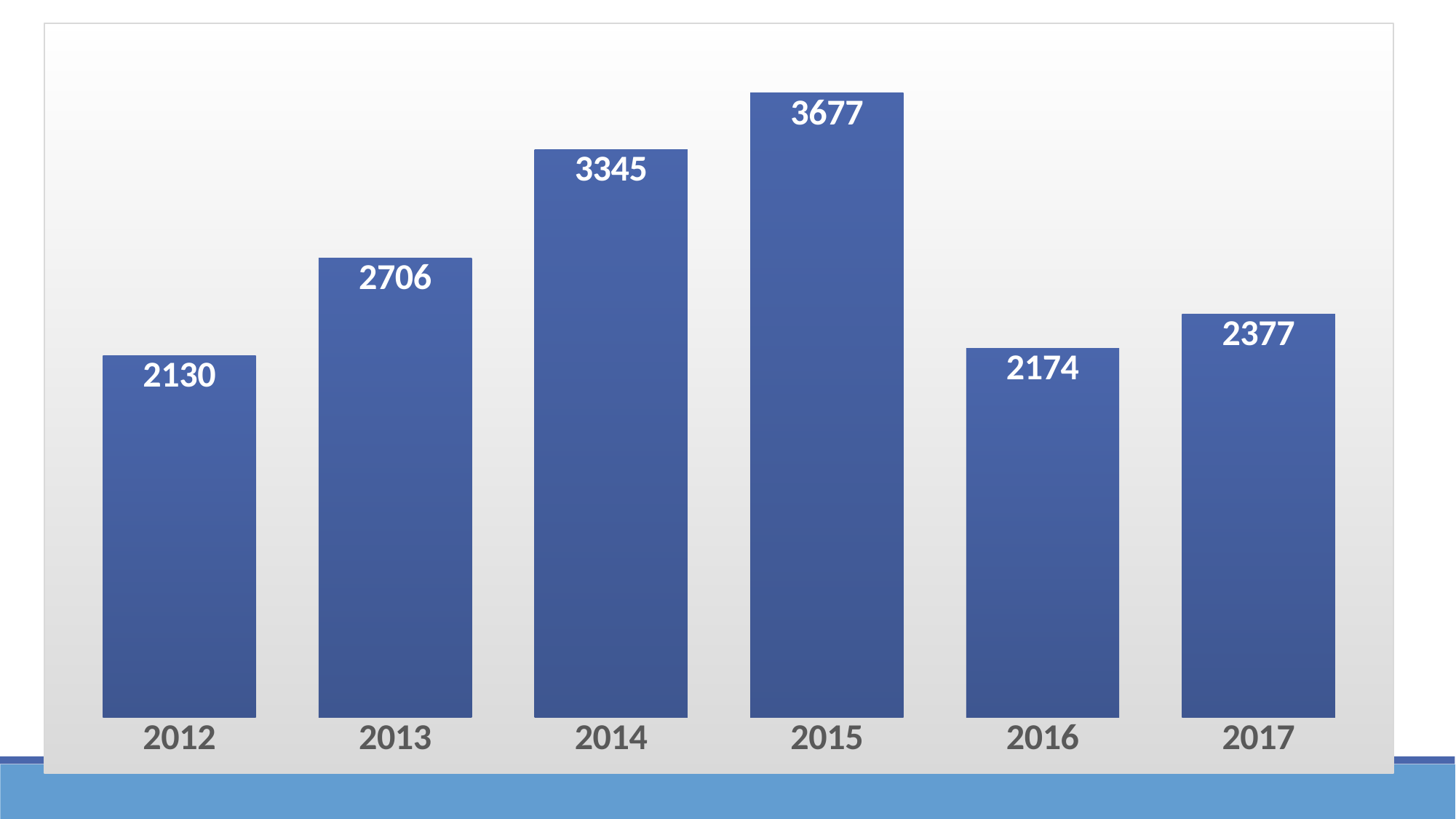
Which is larger, the value for 2013 or the value for 2014? 2014 What is the value for 2012? 2130 Do the values rise or fall from 2012 to 2015? rise What is the value for 2015? 3677 How many years are shown on the x axis? 6 Which year has the lowest value? 2012 What is the difference between the values for 2015 and 2014? 332 What is the difference between the values for 2013 and 2012? 576 Which year has the highest value? 2015 Which is larger, the value for 2016 or the value for 2017? 2017 What kind of chart is shown on the slide? bar chart What is the value for 2017? 2377